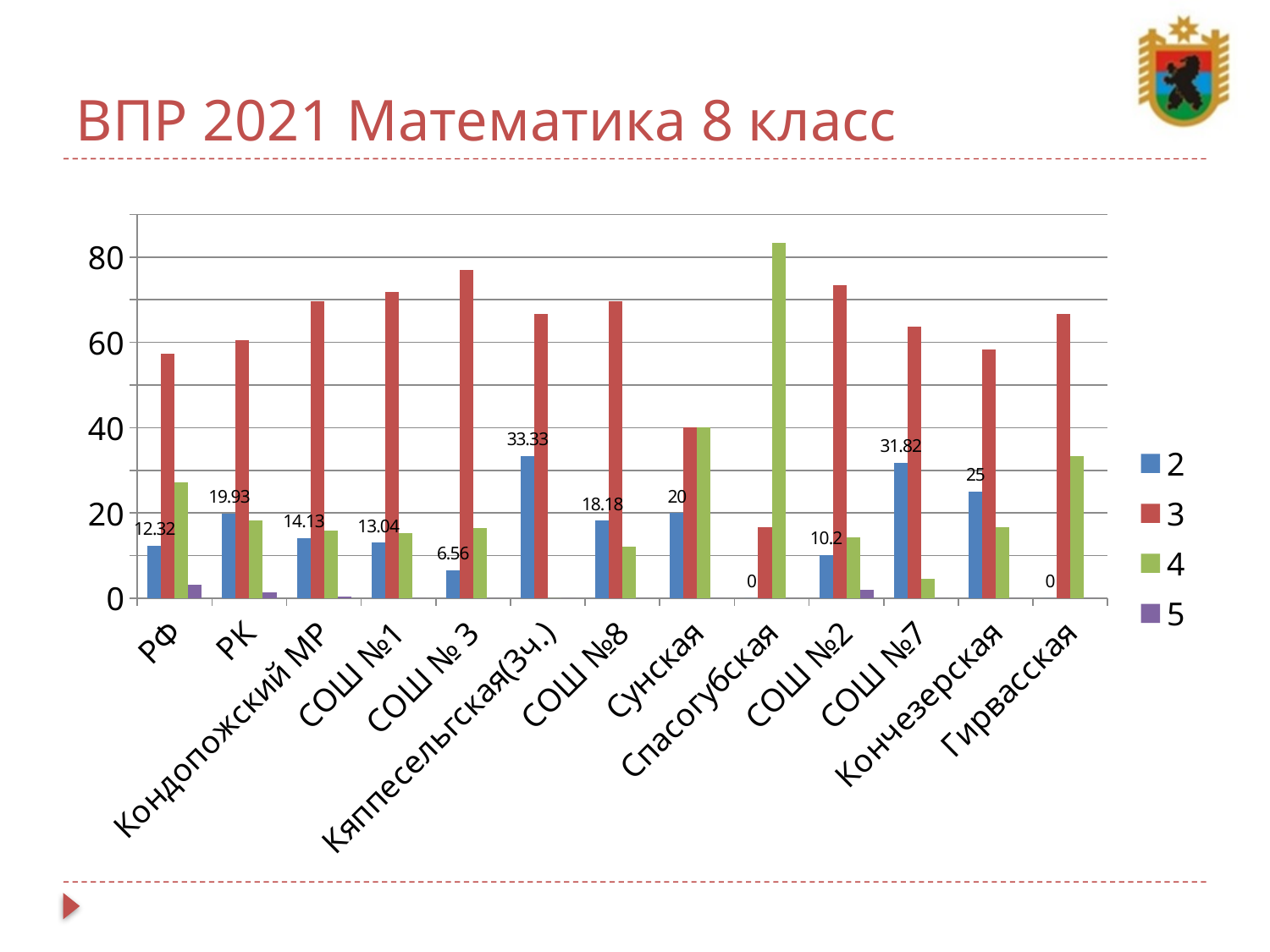
What is the value of series "2" for Кяппесельгская(3ч.)? 33.33 What is the value of series "2" for РФ? 12.32 What is the difference between the series "2" values for РК and РФ? 7.61 How many categories are shown on the x axis? 13 Is the value of series "3" for СОШ № 3 greater or less than 60? greater Is the value of series "4" for Спасогубская greater or less than 80? greater Which category has the highest value in series "2"? Кяппесельгская(3ч.) What is the value of series "2" for СОШ №7? 31.82 Which has the larger series "2" value, Кончезерская or Сунская? Кончезерская How many series does the legend list? 4 What is the value of series "2" for Спасогубская? 0 What kind of chart is shown on the slide? Bar chart